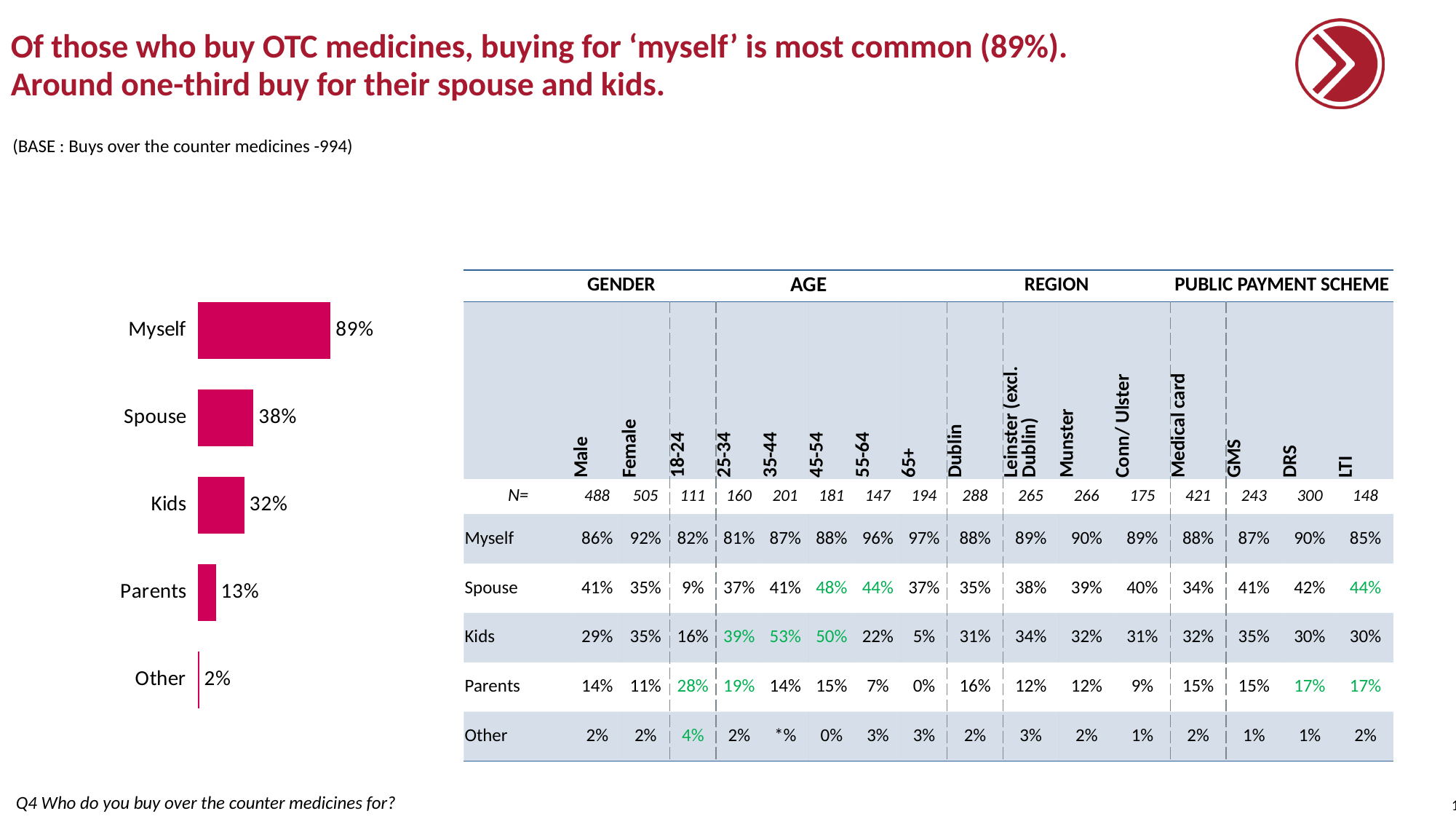
Which category has the lowest value in the bar chart? Other Which is larger in the bar chart, the value for 'Kids' or the value for 'Parents'? Kids Which category has the highest value in the bar chart? Myself What is the difference between the 'Spouse' and 'Kids' values in the bar chart? 6% What is the value shown for 'Parents' in the bar chart? 13% Do the values in the bar chart rise or fall going from 'Myself' at the top to 'Other' at the bottom? Fall What is the value shown for 'Spouse' in the bar chart? 38% What kind of chart is shown on the left of the slide? Bar chart What is the difference between the 'Myself' and 'Spouse' values in the bar chart? 51% How many categories are shown in the bar chart? 5 What percentage of OTC medicine buyers buy for 'Myself' according to the bar chart? 89% What is the value shown for 'Other' in the bar chart? 2%